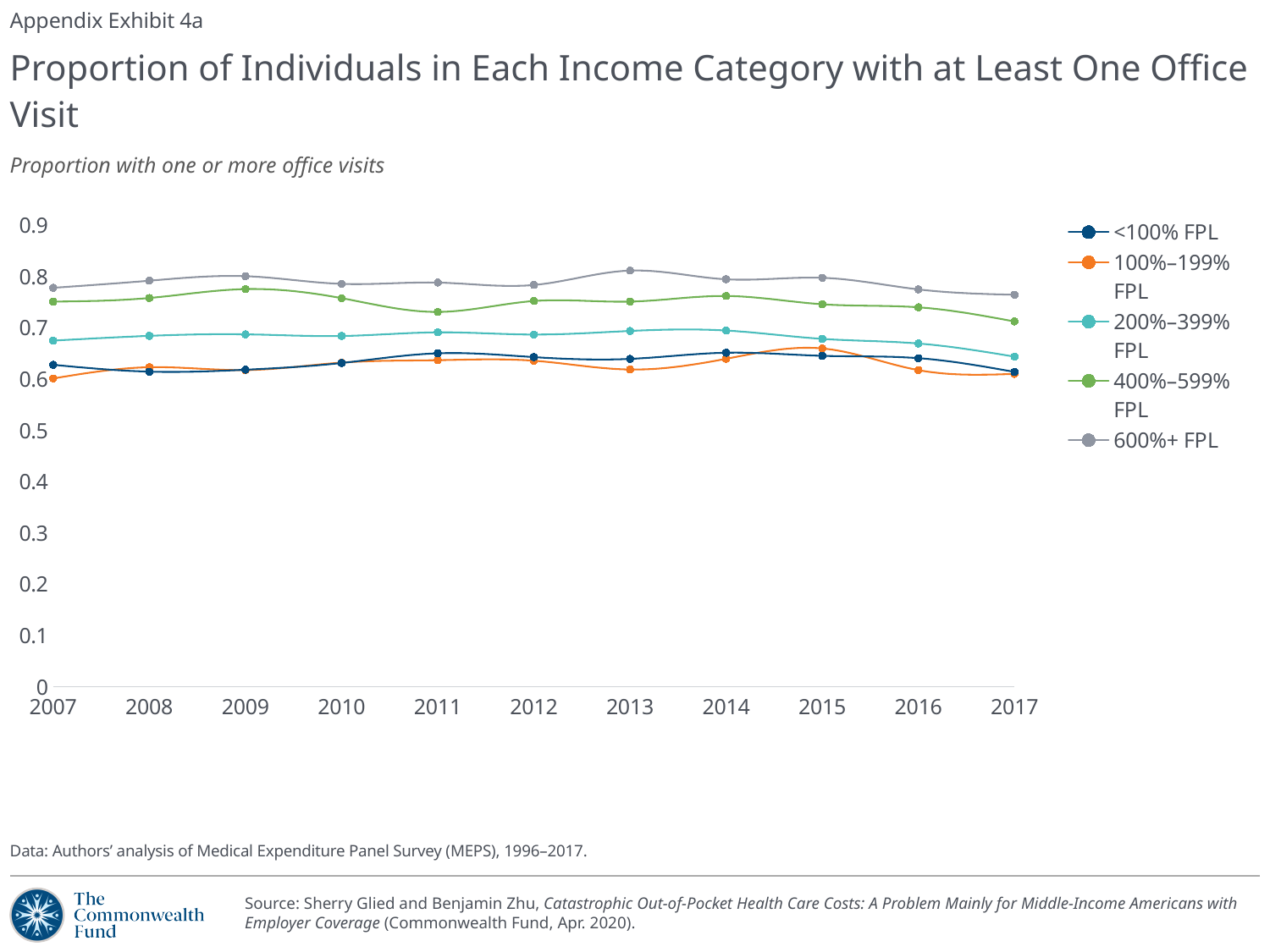
How many series does the legend list? 5 In 2009, which is larger: the value for 400%–599% FPL or the value for 200%–399% FPL? 400%–599% FPL What kind of chart is shown on the slide? line chart In 2013, which is larger: the value for 600%+ FPL or the value for <100% FPL? 600%+ FPL Is the value for <100% FPL in 2017 greater or less than 0.7? less Which series has the lowest value in 2007? 100%–199% FPL Does the value for 400%–599% FPL rise or fall from 2014 to 2017? fall Is the value for 600%+ FPL in 2007 greater or less than 0.7? greater What is the title of the chart? Proportion of Individuals in Each Income Category with at Least One Office Visit How many years are plotted along the x axis? 11 Is the value for 400%–599% FPL in 2011 greater or less than 0.7? greater Which series has the highest value in 2013? 600%+ FPL